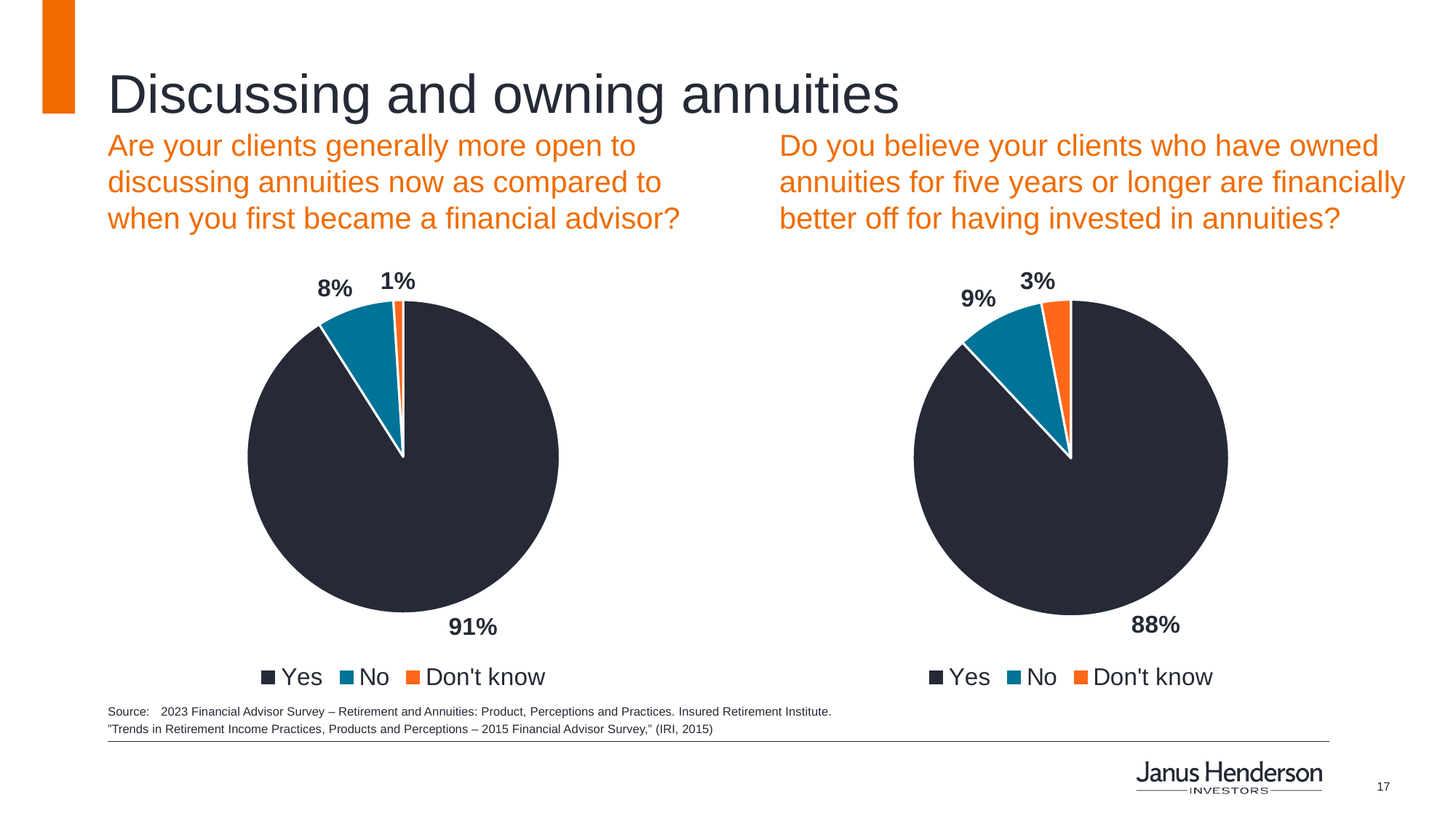
In the left pie chart (clients more open to discussing annuities), what percentage answered Don't know? 1% In the right pie chart (clients financially better off from annuities), what percentage answered Don't know? 3% Which is larger: the No share in the left pie chart or the No share in the right pie chart? The right pie chart (9%) What is the difference between the Yes share in the left pie chart and the Yes share in the right pie chart? 3 percentage points In the left pie chart (clients more open to discussing annuities), what percentage answered Yes? 91% What type of chart is used on this slide? Pie chart In the left pie chart, which response has the largest share? Yes In the right pie chart (clients financially better off from annuities), what percentage answered No? 9% In the right pie chart, which response has the smallest share? Don't know How many entries does the legend of the left pie chart list? 3 In the left pie chart (clients more open to discussing annuities), what percentage answered No? 8% In the right pie chart (clients financially better off from annuities), what percentage answered Yes? 88%